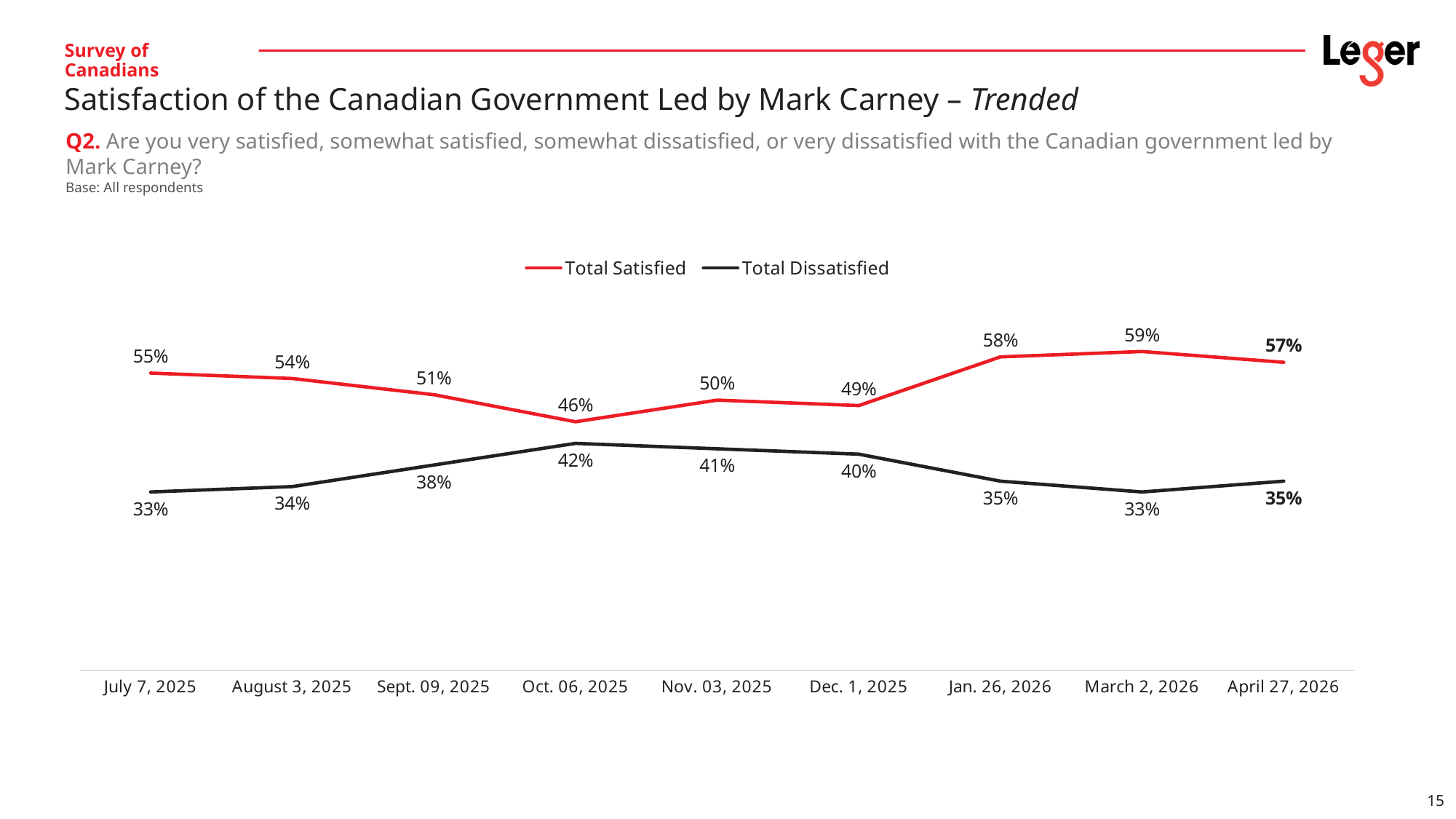
What is the difference between Total Satisfied and Total Dissatisfied on April 27, 2026? 22 percentage points What is the Total Dissatisfied value for Oct. 06, 2025? 42% What is the Total Satisfied value for July 7, 2025? 55% On which date is Total Satisfied highest? March 2, 2026 On which date is Total Satisfied lowest? Oct. 06, 2025 Which is larger: Total Dissatisfied on Sept. 09, 2025 or on Dec. 1, 2025? Dec. 1, 2025 What is the Total Satisfied value for April 27, 2026? 57% How many dates are plotted on the x axis? 9 What kind of chart is shown on the slide? Line chart On which date is Total Dissatisfied highest? Oct. 06, 2025 What is the difference between Total Satisfied on Oct. 06, 2025 and on Jan. 26, 2026? 12 percentage points How many series does the legend list? 2